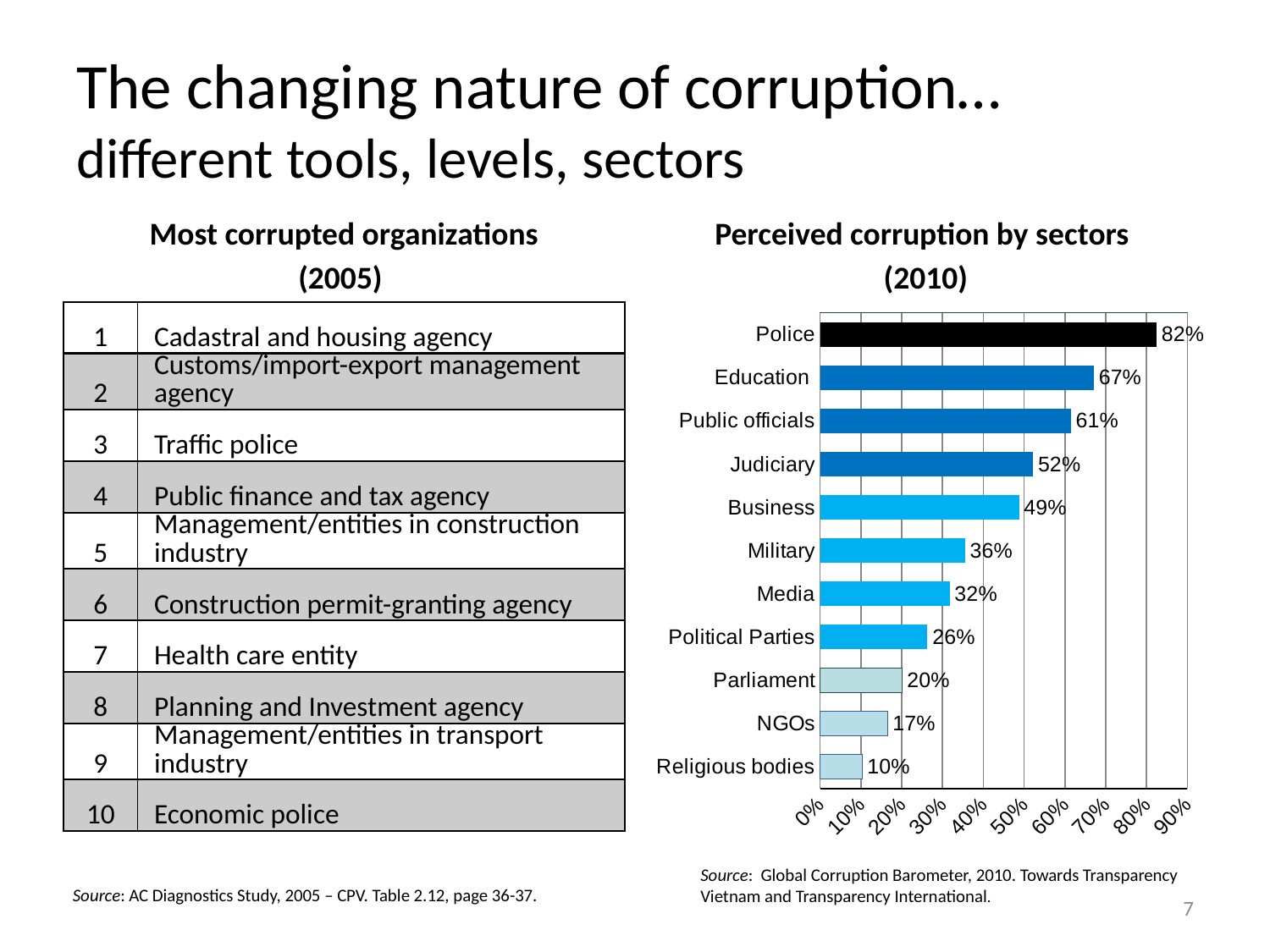
What is the value for Police in the Perceived corruption by sectors (2010) chart? 82% What is the value for Parliament in the Perceived corruption by sectors (2010) chart? 20% Which sector has the lowest value in the Perceived corruption by sectors (2010) chart? Religious bodies What is the difference between the values for Police and Religious bodies in the Perceived corruption by sectors (2010) chart? 72% What kind of chart is the Perceived corruption by sectors (2010) chart? bar chart How many sectors are shown in the Perceived corruption by sectors (2010) chart? 11 In the Perceived corruption by sectors (2010) chart, is the value for Business greater or less than 40%? greater In the Perceived corruption by sectors (2010) chart, which is larger, the value for Military or the value for Media? Military What is the value for Judiciary in the Perceived corruption by sectors (2010) chart? 52% What is the difference between the values for Education and Public officials in the Perceived corruption by sectors (2010) chart? 6% Which sector has the highest value in the Perceived corruption by sectors (2010) chart? Police What is the title of the chart on the right side of the slide? Perceived corruption by sectors (2010)